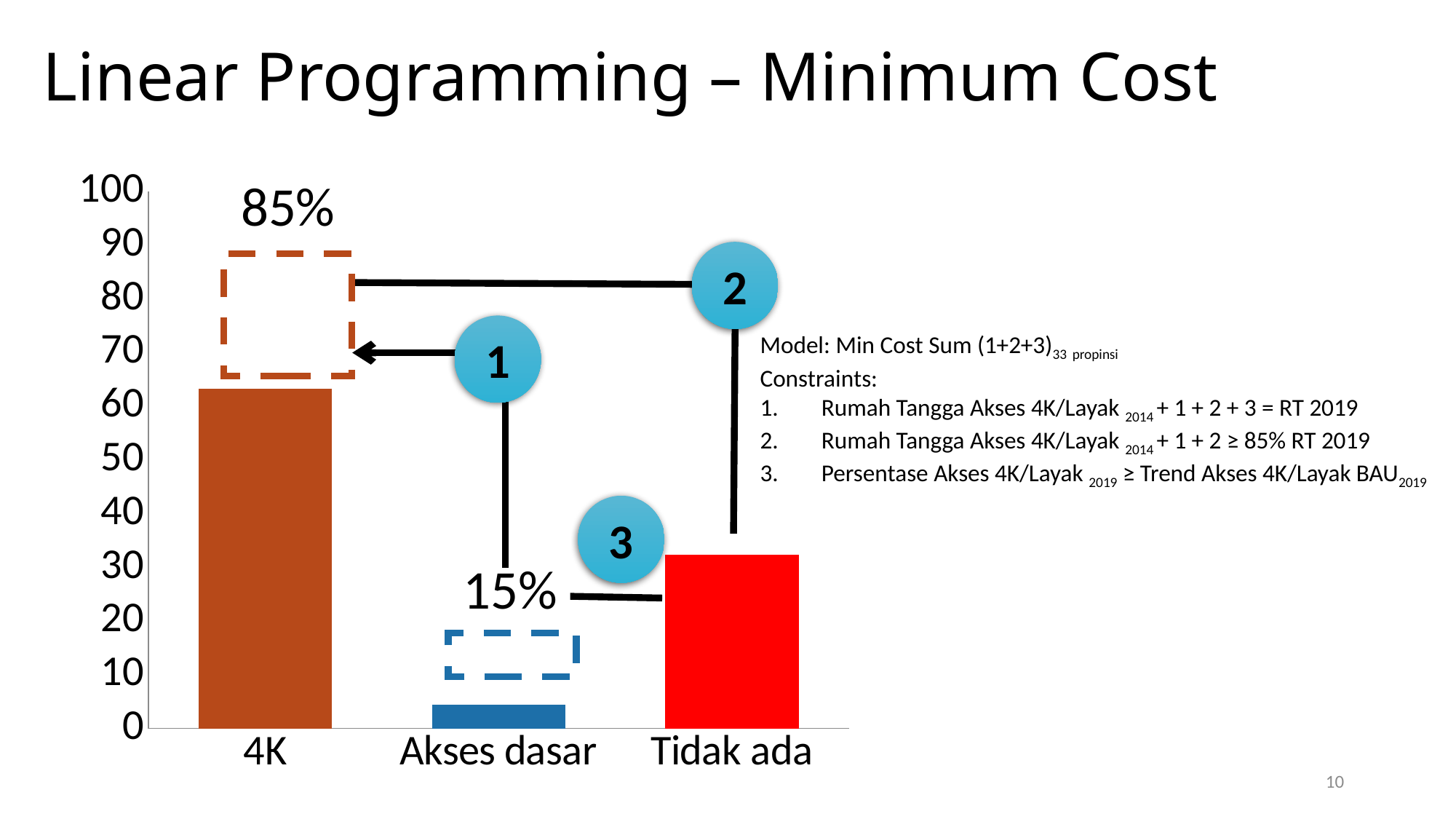
Which bar is taller, 4K or Tidak ada? 4K What kind of chart is shown on the slide? bar chart Which category has the shortest bar? Akses dasar What is the highest value shown on the y axis of the chart? 100 What colour is the bar for Tidak ada? red Is the value for 4K greater or less than 60? greater Is the value for Akses dasar greater or less than 10? less Which bar is taller, Tidak ada or Akses dasar? Tidak ada Is the value for Tidak ada greater or less than 30? greater How many categories are shown on the x axis of the chart? 3 Which category has the tallest bar? 4K